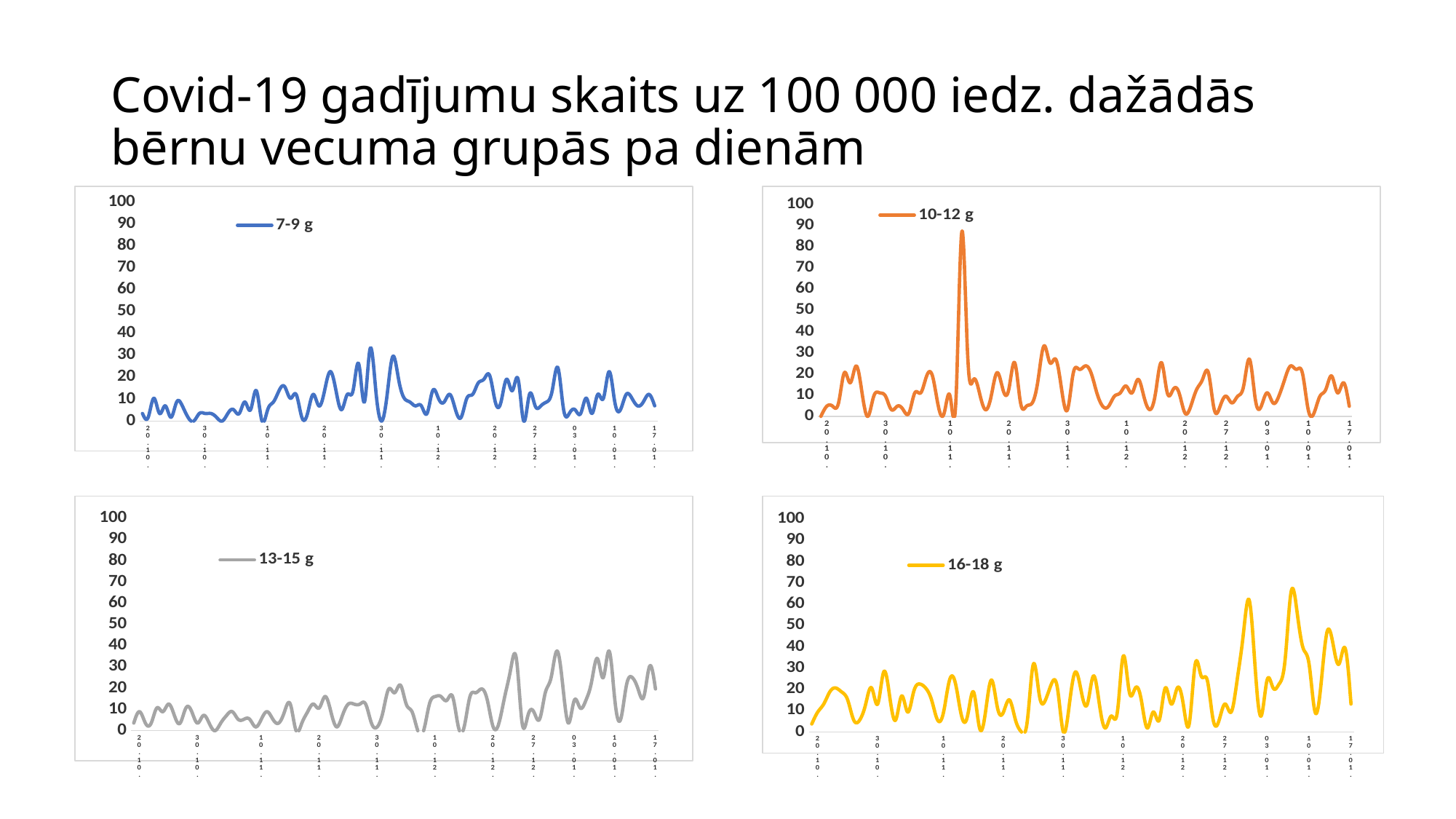
In the top-left chart (7-9 g), is the highest peak of the line greater or less than 40? less Which chart shows the higher maximum value: the bottom-left chart (13-15 g) or the bottom-right chart (16-18 g)? 16-18 g What is the legend entry of the bottom-right chart? 16-18 g How many series does the legend of the top-right chart list? 1 What is the highest value shown on the vertical axis of the bottom-left chart (13-15 g)? 100 What is the legend entry of the bottom-left chart? 13-15 g What kind of chart is the top-left chart with the legend entry "7-9 g"? line chart In the top-right chart (10-12 g), is the highest peak of the line greater or less than 80? greater Which chart shows the higher maximum value: the top-left chart (7-9 g) or the top-right chart (10-12 g)? 10-12 g In the bottom-right chart (16-18 g), do the values generally rise or fall from left to right along the x axis? rise In the bottom-left chart (13-15 g), is the highest peak of the line greater or less than 50? less